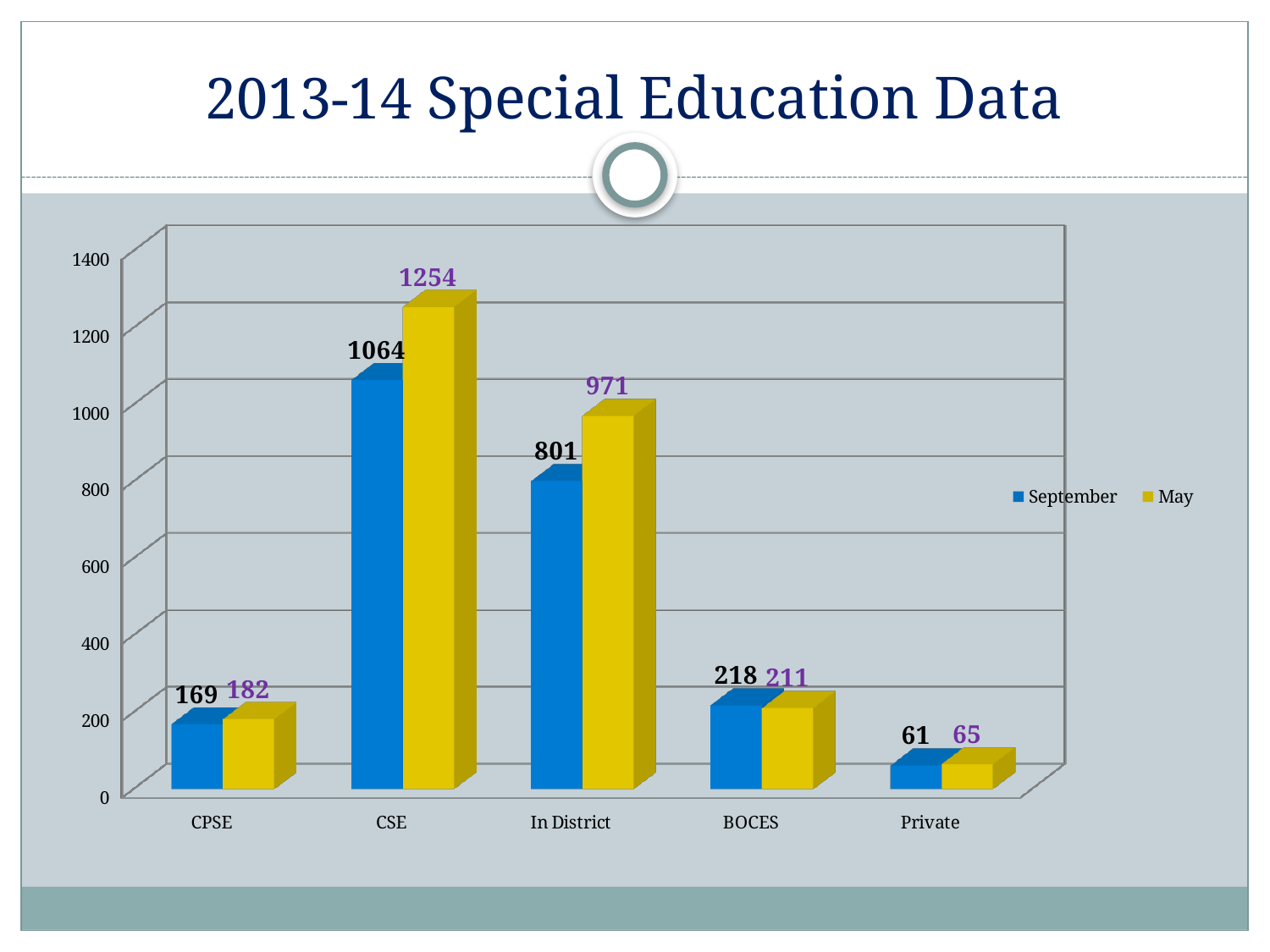
What is the May value for In District? 971 What is the May value for Private? 65 What is the difference between the September and May values for BOCES? 7 What kind of chart is shown on the slide? Bar chart For BOCES, which is larger: the September value or the May value? September What is the difference between the May and September values for CSE? 190 Which category has the highest May value? CSE What colour represents the May series? Yellow How many series does the legend list? 2 What is the September value for CSE? 1064 Which category has the lowest September value? Private How many categories are shown on the x axis? 5